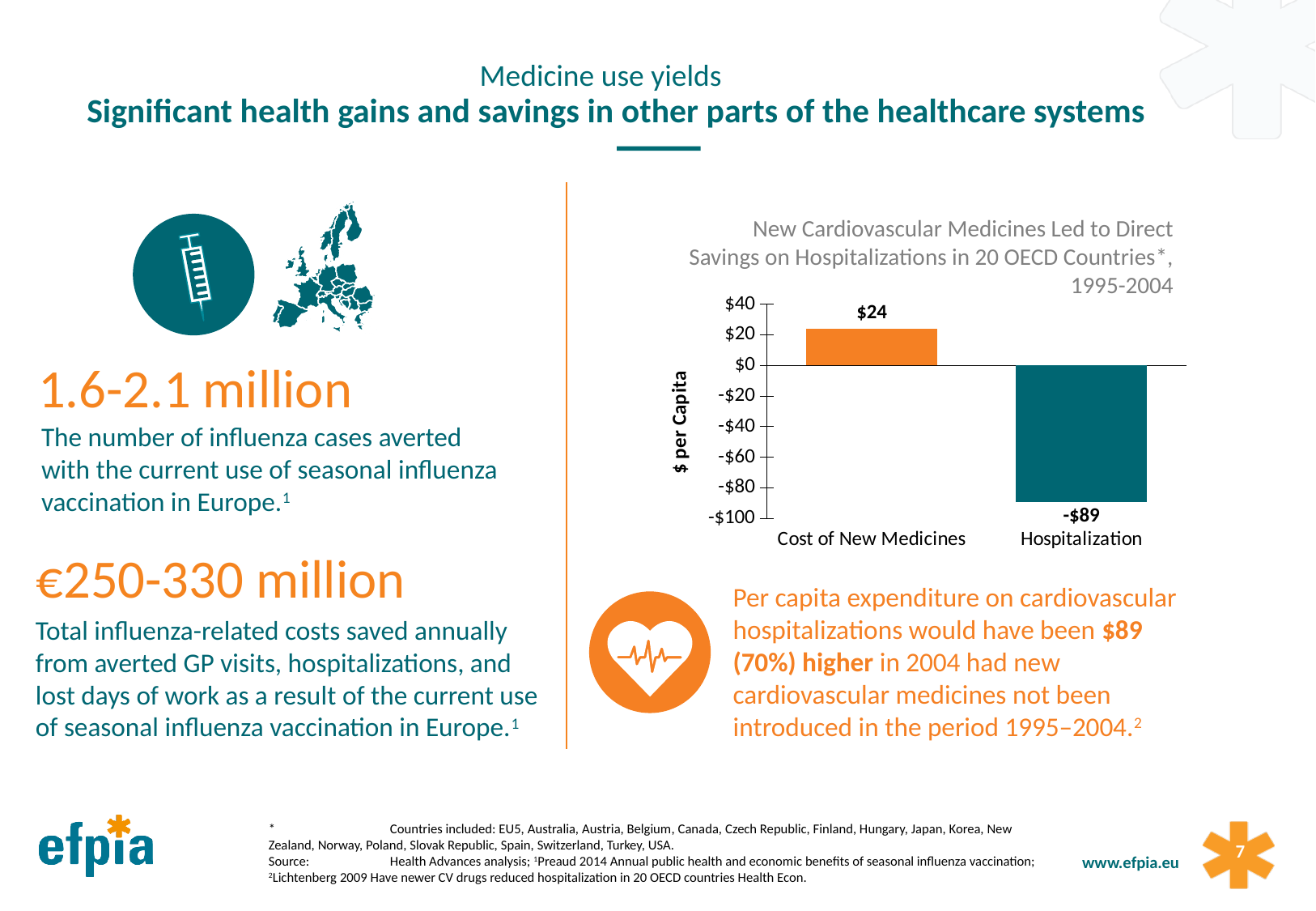
Is the value for Hospitalization greater or less than -$80? less What is the value for Hospitalization in the chart? -$89 Is the value for Cost of New Medicines greater or less than $20? greater What is the value for Cost of New Medicines in the chart? $24 Which category in the chart has the lowest value? Hospitalization What kind of chart is shown on the slide? bar chart What is the title of the chart? New Cardiovascular Medicines Led to Direct Savings on Hospitalizations in 20 OECD Countries*, 1995-2004 Which category in the chart has the higher value? Cost of New Medicines Is the value for Cost of New Medicines larger or smaller than the value for Hospitalization? larger What is the label of the vertical axis of the chart? $ per Capita How many categories are shown in the chart? 2 What is the difference between the value for Cost of New Medicines and the value for Hospitalization? $113